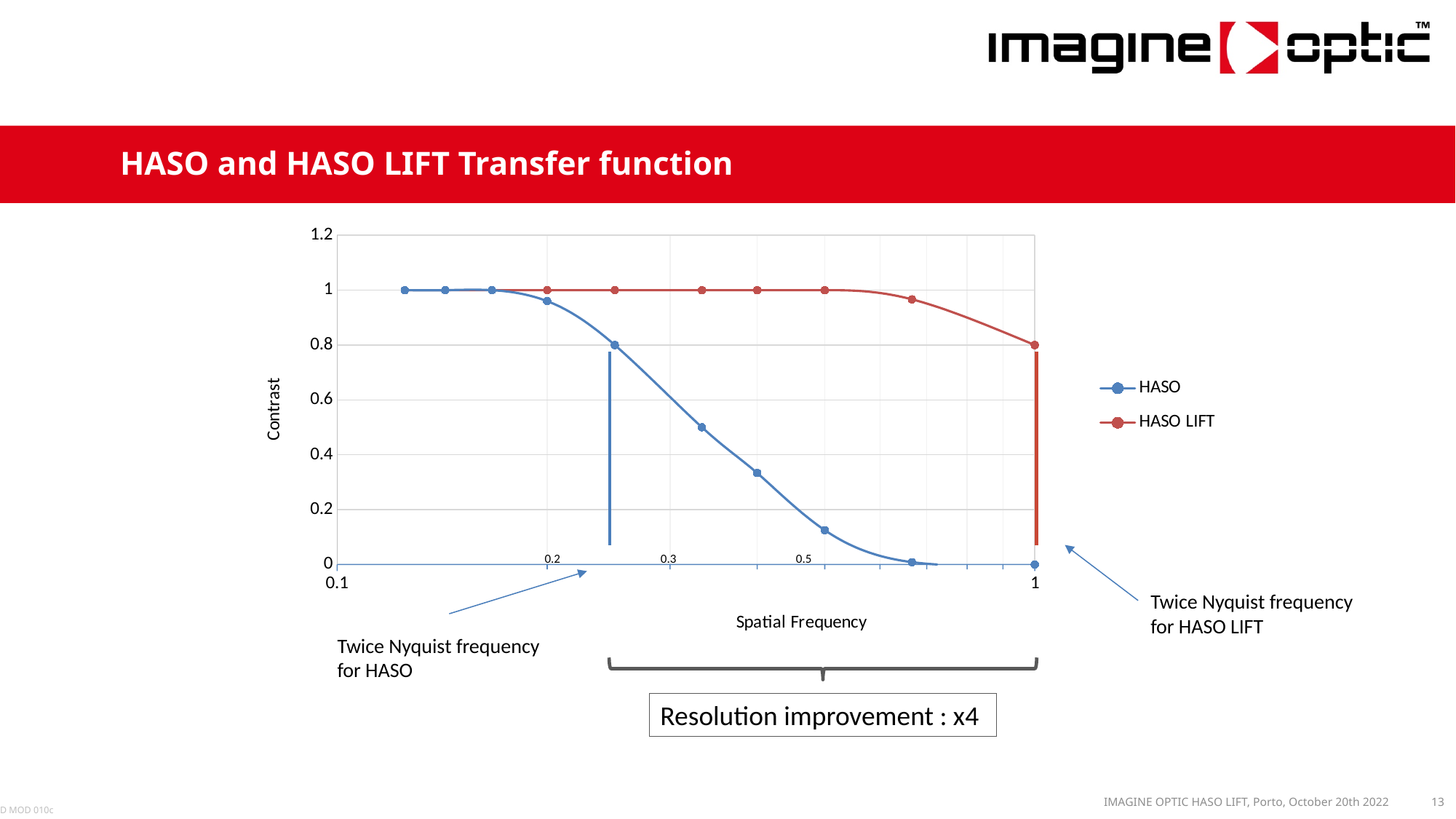
What is the contrast value of the HASO series at a spatial frequency of 1? 0 Does the contrast of the HASO series rise or fall as spatial frequency increases? fall What is the contrast value of the HASO LIFT series at a spatial frequency of 1? 0.8 Which series reaches the lower contrast at a spatial frequency of 1? HASO How many series does the legend list? 2 Is the contrast of the HASO LIFT series at a spatial frequency of 0.5 greater or less than 0.8? greater What are the two series named in the legend? HASO and HASO LIFT At a spatial frequency of 0.5, which series has the higher contrast, HASO or HASO LIFT? HASO LIFT Is the contrast of the HASO series at a spatial frequency of 0.5 greater or less than 0.4? less What kind of chart is shown on the slide? line chart What is the title of the vertical axis? Contrast